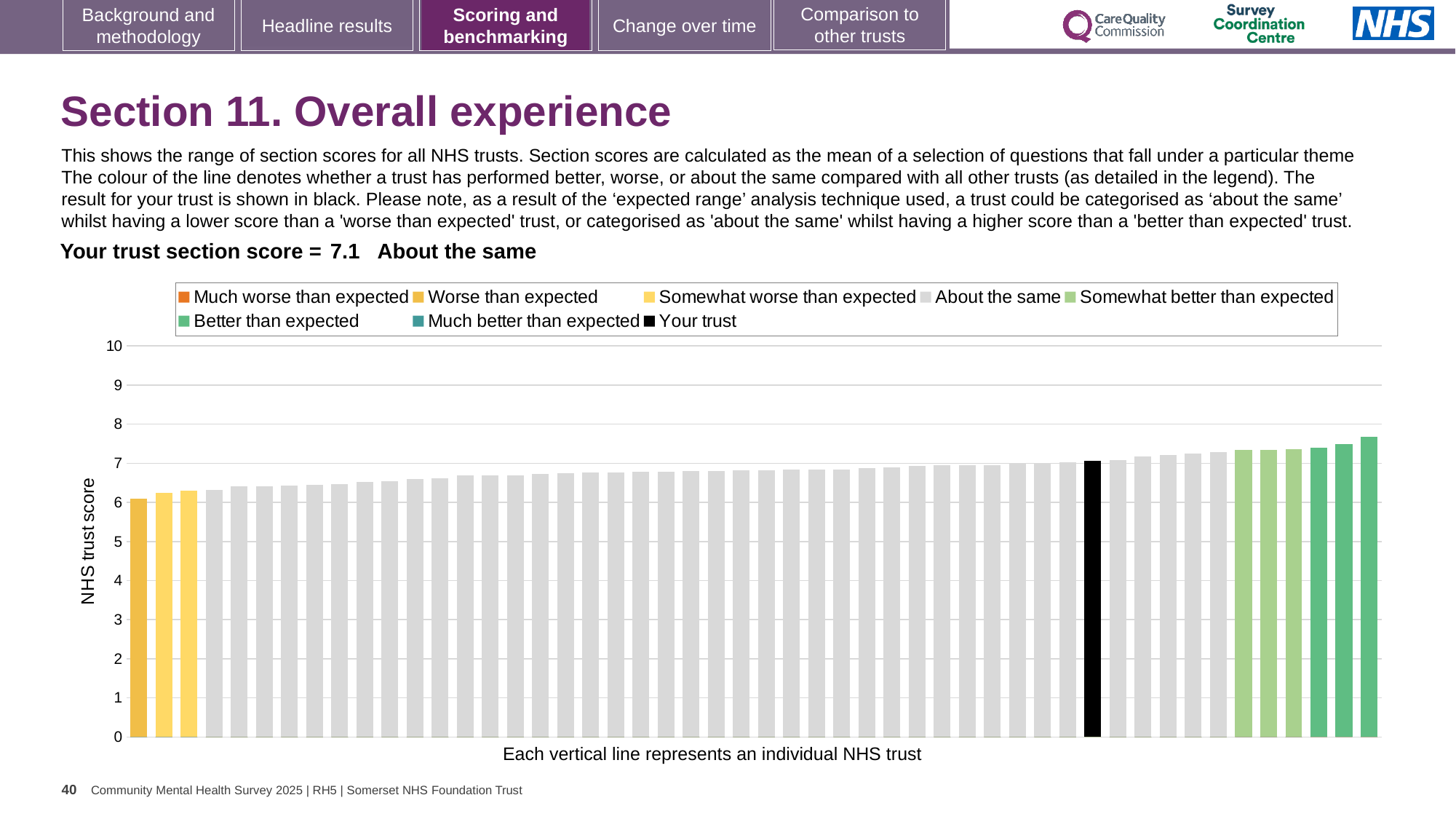
What is the section score for your trust shown on the slide? 7.1 Is the value of the leftmost bar greater or less than 7? less Is the value of the black 'Your trust' bar greater or less than 8? less What colour is used for the 'Your trust' bar in the chart? black Is the value of the black 'Your trust' bar greater or less than 6? greater Do the bar values rise or fall from left to right across the chart? rise How many entries does the chart legend list? 8 What is the label on the vertical axis of the chart? NHS trust score What is the highest value shown on the vertical axis? 10 What kind of chart is shown on the slide? bar chart Which category is your trust placed in for this section? About the same